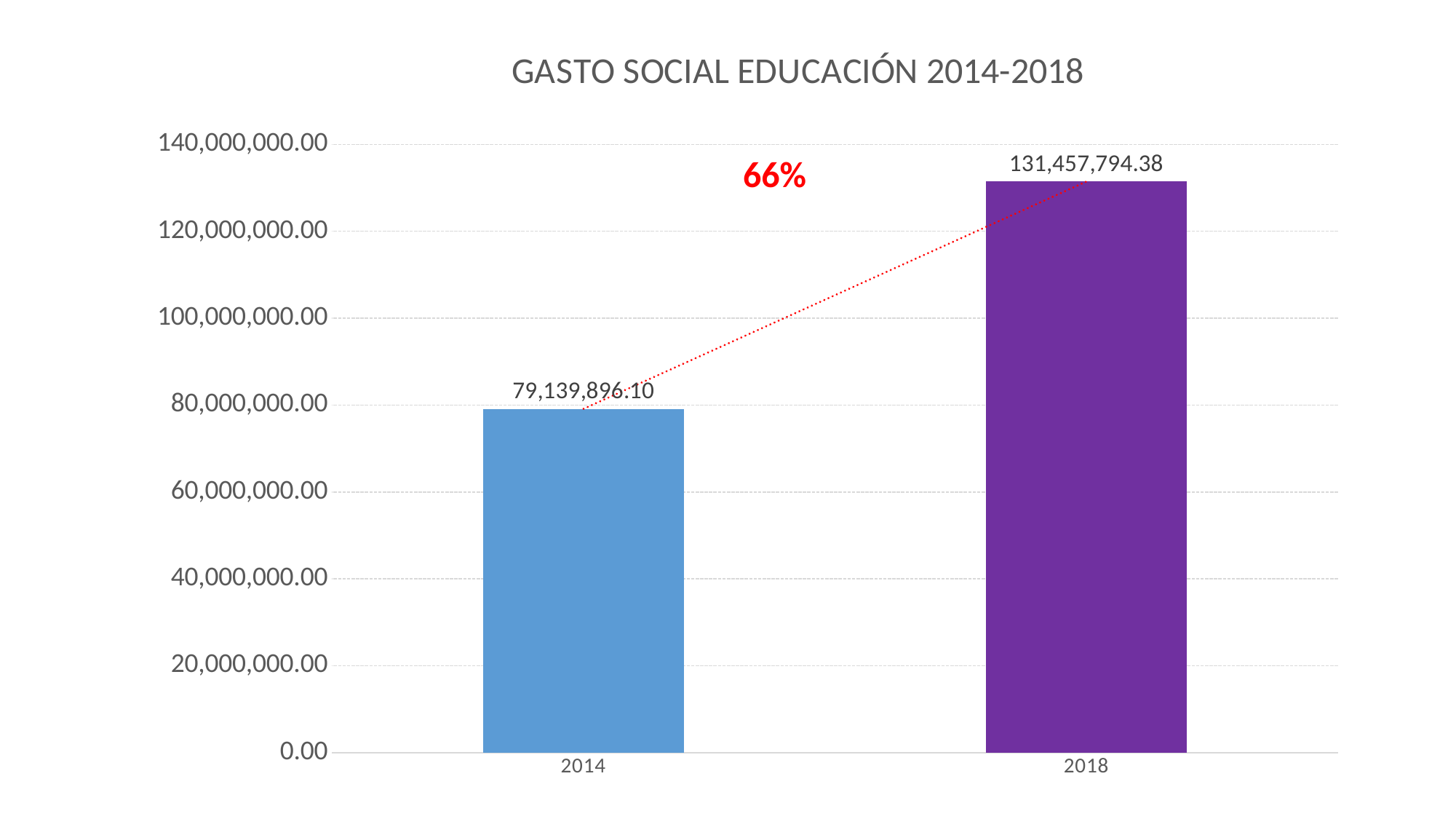
Which year has the highest value? 2018 What is the value for 2014? 79,139,896.10 Is the value for 2018 greater or less than 120,000,000.00? greater What percentage is shown in red between the two bars? 66% Which year has the lowest value? 2014 What is the value for 2018? 131,457,794.38 Is the value for 2014 greater or less than 80,000,000.00? less How many bars are shown in the chart? 2 What kind of chart is shown on the slide? bar chart What is the difference between the 2018 value and the 2014 value? 52,317,898.28 Which is larger, the value for 2014 or the value for 2018? 2018 Do the values rise or fall from 2014 to 2018? rise